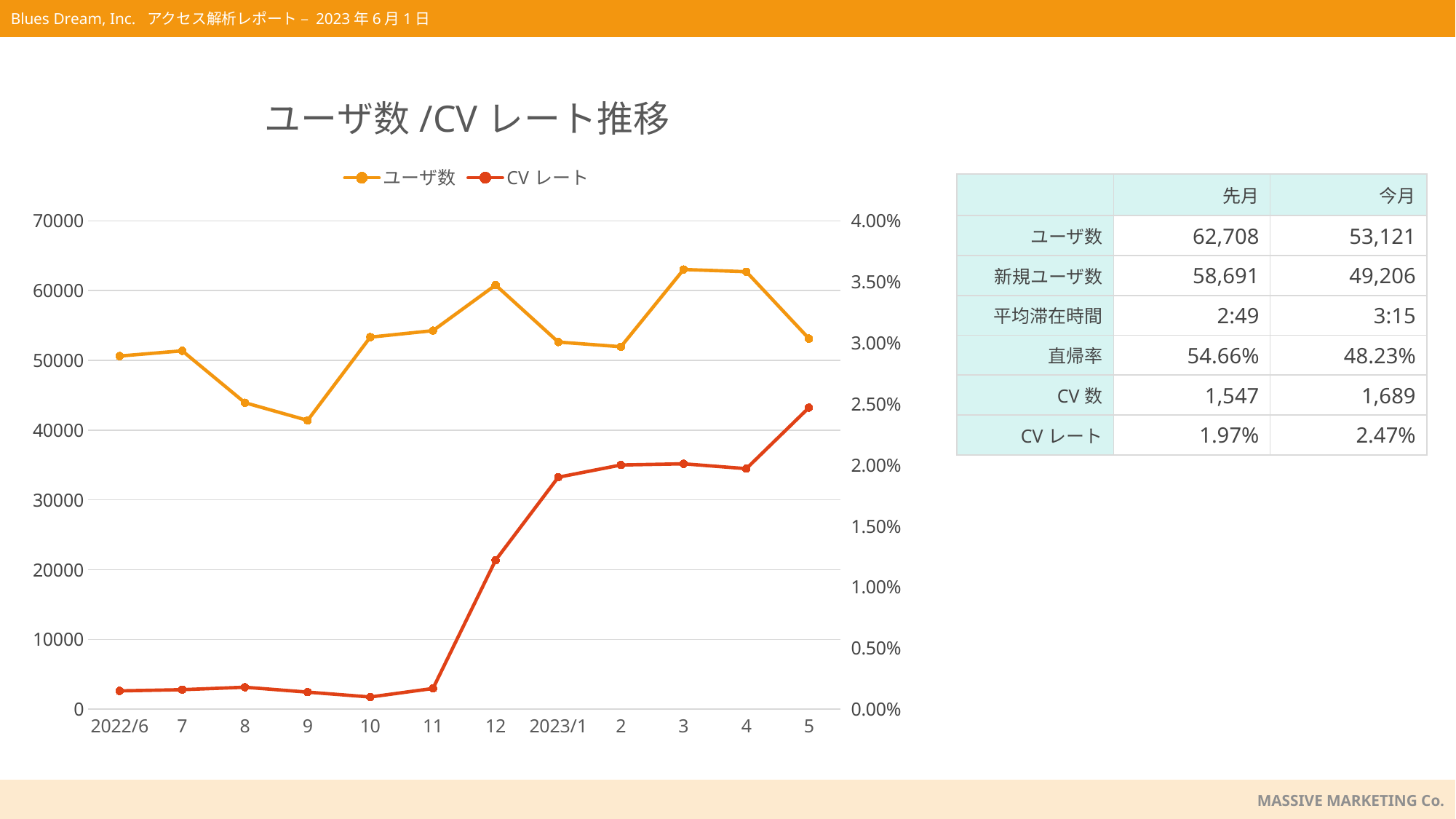
Is the CV レート value for 2022/10 greater or less than 0.50%? less What kind of chart is shown on the slide? Line chart Which colour is used for the CV レート line in the chart? Red How many months are plotted along the x axis of the chart? 12 Is the ユーザ数 value for 2023/3 greater or less than 60000? greater How many series does the chart legend list? 2 In which month is the CV レート value highest? 2023/5 Is the ユーザ数 value for 2022/9 greater or less than 50000? less What is the title of the chart? ユーザ数 /CV レート推移 Which month has the larger ユーザ数 value, 2022/12 or 2023/1? 2022/12 In which month is the ユーザ数 value lowest? 2022/9 Does the CV レート line generally rise or fall from 2022/6 to 2023/5? Rise